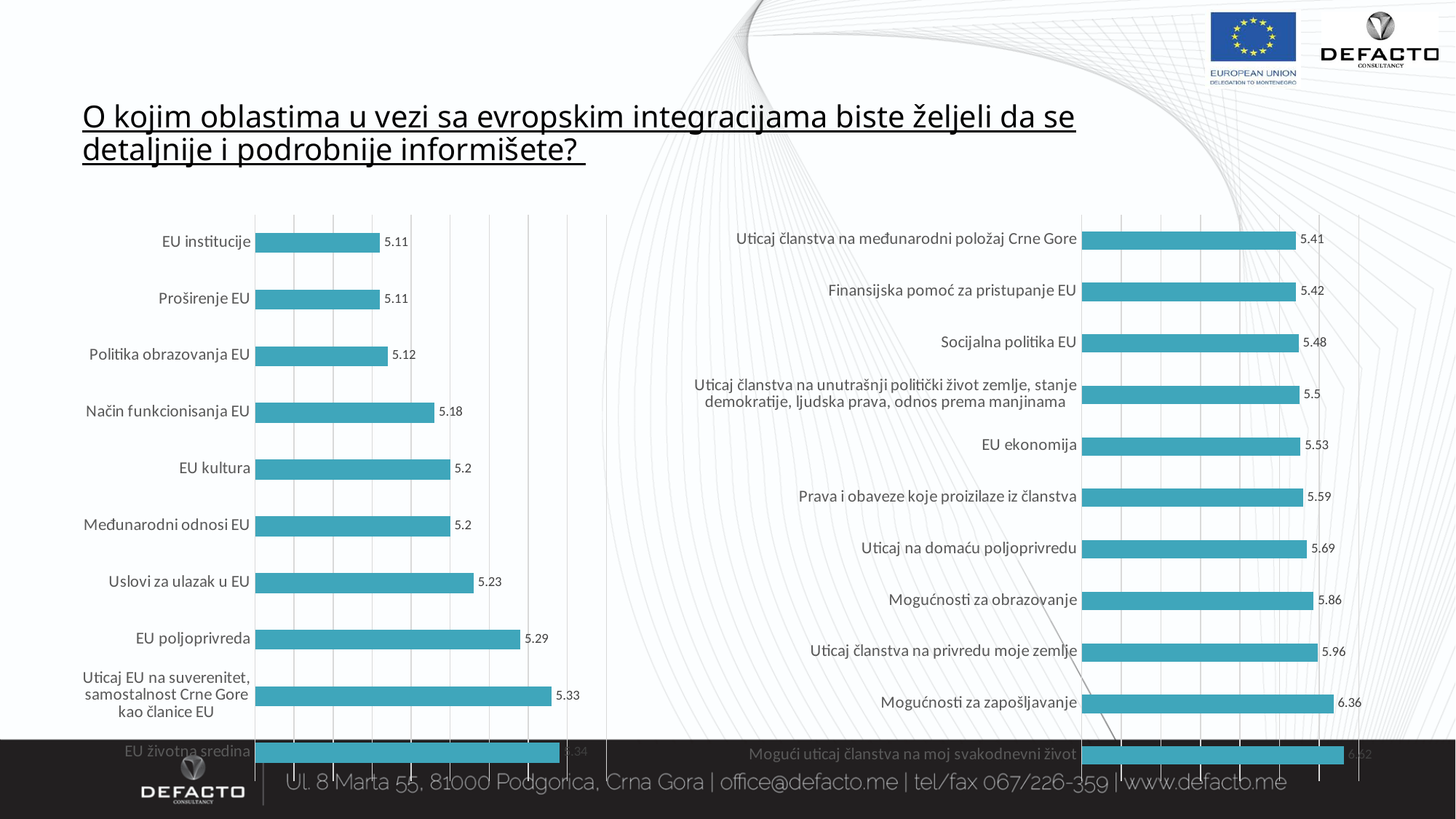
What kind of chart is the left chart? Bar chart In the right chart, which is larger: Uticaj članstva na privredu moje zemlje or EU ekonomija? Uticaj članstva na privredu moje zemlje In the right chart, what is the value for Prava i obaveze koje proizilaze iz članstva? 5.59 In the left chart, what is the value for EU poljoprivreda? 5.29 In the left chart, what is the value for Način funkcionisanja EU? 5.18 In the right chart, what is the value for Socijalna politika EU? 5.48 In the left chart, which is larger: Uslovi za ulazak u EU or Politika obrazovanja EU? Uslovi za ulazak u EU In the left chart, what is the difference between EU poljoprivreda and EU institucije? 0.18 In the left chart, what is the value for Uslovi za ulazak u EU? 5.23 In the right chart, what is the value for Mogućnosti za zapošljavanje? 6.36 In the right chart, what is the value for Uticaj na domaću poljoprivredu? 5.69 In the right chart, what is the difference between Mogućnosti za zapošljavanje and Mogućnosti za obrazovanje? 0.5